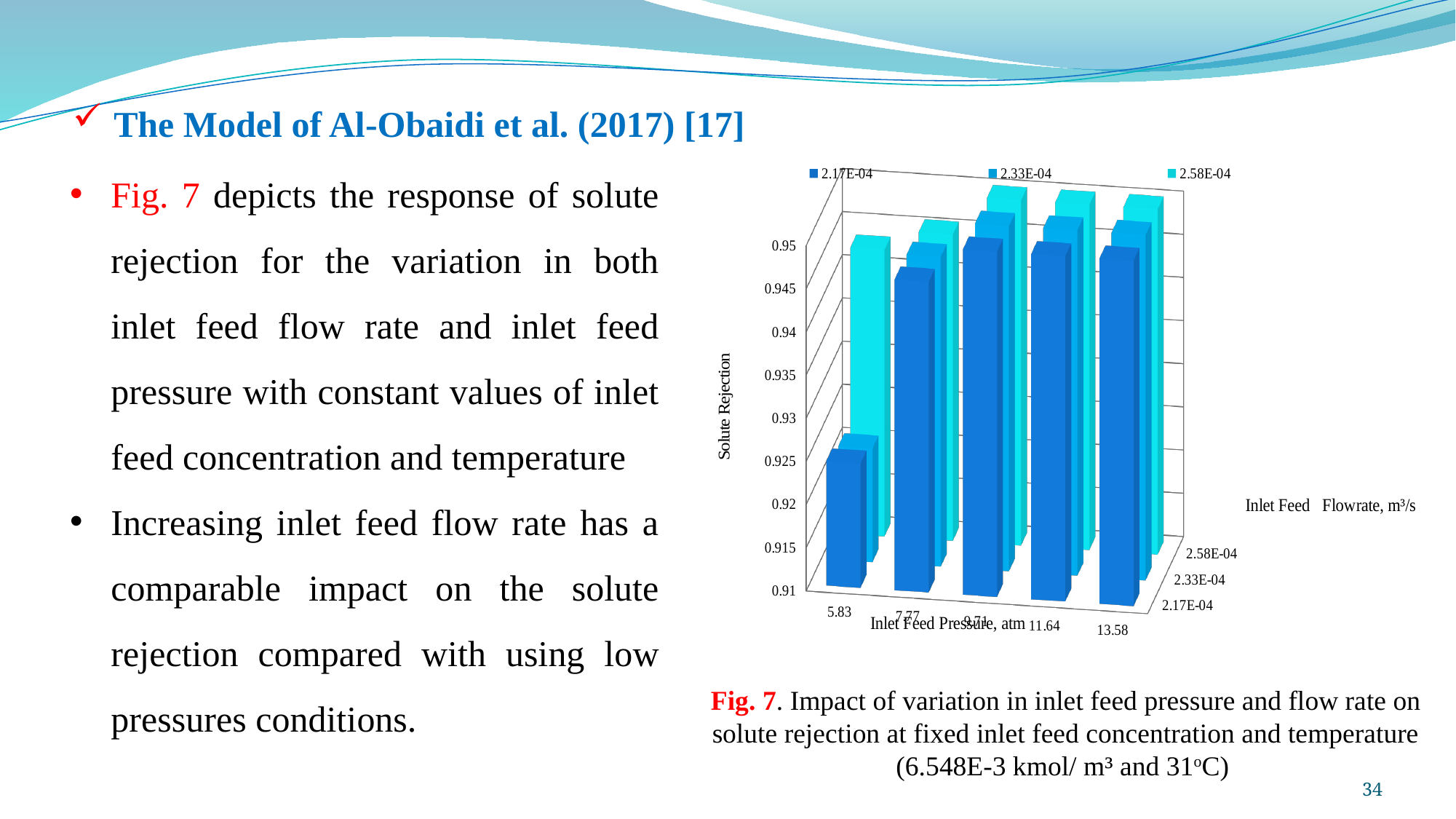
At an inlet feed pressure of 5.83 atm, which series has the higher solute rejection: 2.17E-04 or 2.58E-04? 2.58E-04 How many inlet feed pressure values are plotted along the x axis of the chart? 5 What kind of chart is shown in Fig. 7? bar chart Which inlet feed pressure has the lowest solute rejection for the 2.17E-04 series? 5.83 Is the solute rejection for the 2.58E-04 series at 5.83 atm greater or less than 0.93? greater For the 2.17E-04 series, is solute rejection larger at 5.83 atm or at 7.77 atm? 7.77 atm How many series does the legend of the chart list? 3 What is the title of the horizontal axis of the chart? Inlet Feed Pressure, atm What is the title of the vertical axis of the chart? Solute Rejection Is the solute rejection for the 2.17E-04 series at 5.83 atm greater or less than 0.94? less For the 2.17E-04 series, does solute rejection rise or fall as inlet feed pressure increases from 5.83 to 9.71 atm? rise